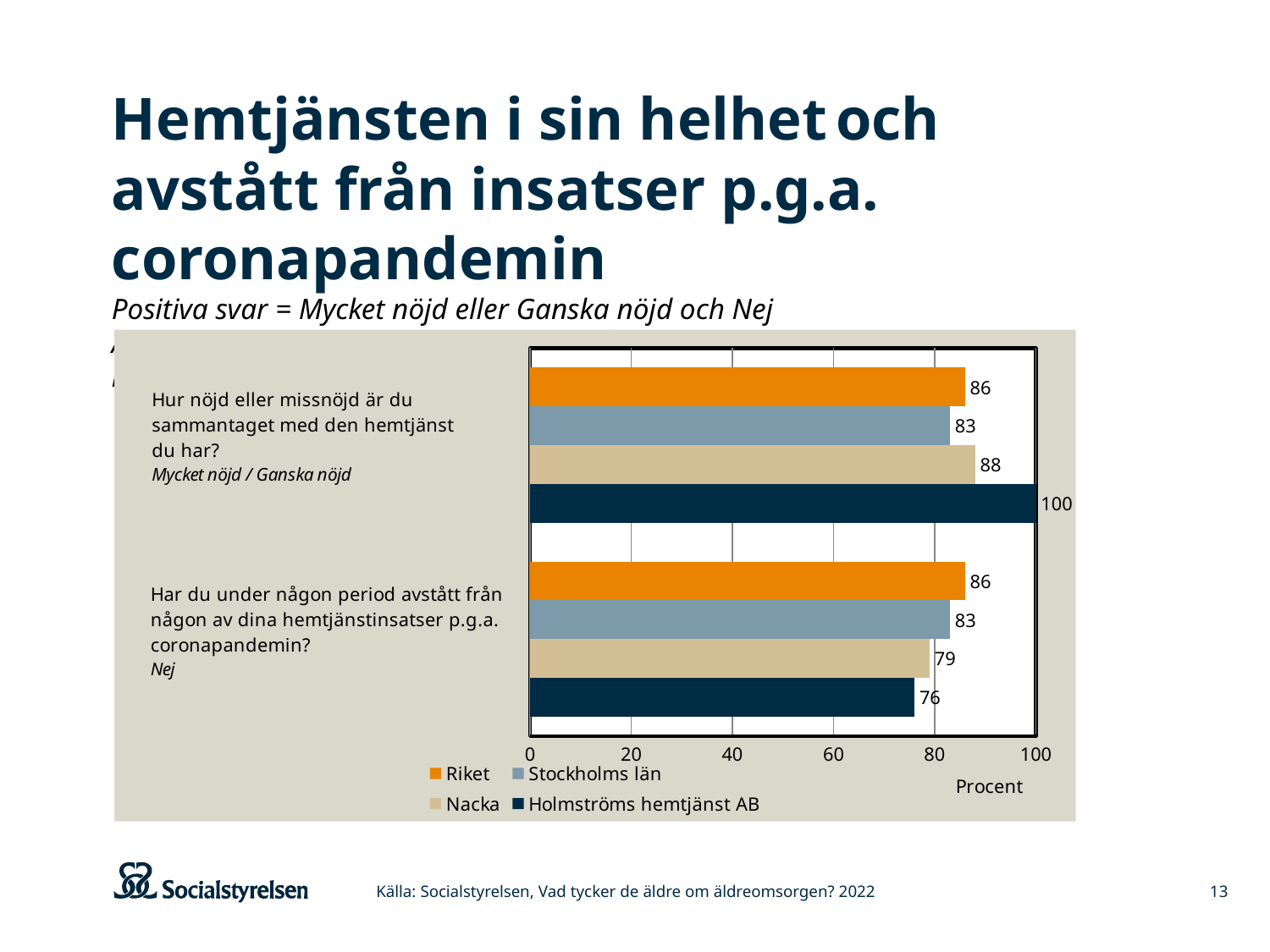
Which series has the lowest value for the question 'Har du under någon period avstått från någon av dina hemtjänstinsatser p.g.a. coronapandemin?' Holmströms hemtjänst AB What is the value for Riket for the question 'Har du under någon period avstått från någon av dina hemtjänstinsatser p.g.a. coronapandemin?' 86 What is the value for Nacka for the question 'Har du under någon period avstått från någon av dina hemtjänstinsatser p.g.a. coronapandemin?' 79 What kind of chart is shown on the slide? bar chart What label is shown on the horizontal axis of the chart? Procent How many question categories are shown on the chart? 2 What is the value for Stockholms län for the question 'Hur nöjd eller missnöjd är du sammantaget med den hemtjänst du har?' 83 What is the difference between the Holmströms hemtjänst AB values for the two questions? 24 How many series does the legend list? 4 Which series has the highest value for the question 'Hur nöjd eller missnöjd är du sammantaget med den hemtjänst du har?' Holmströms hemtjänst AB What is the value for Holmströms hemtjänst AB for the question 'Hur nöjd eller missnöjd är du sammantaget med den hemtjänst du har?' 100 For the question 'Har du under någon period avstått från någon av dina hemtjänstinsatser p.g.a. coronapandemin?', which is larger: the value for Riket or the value for Nacka? Riket